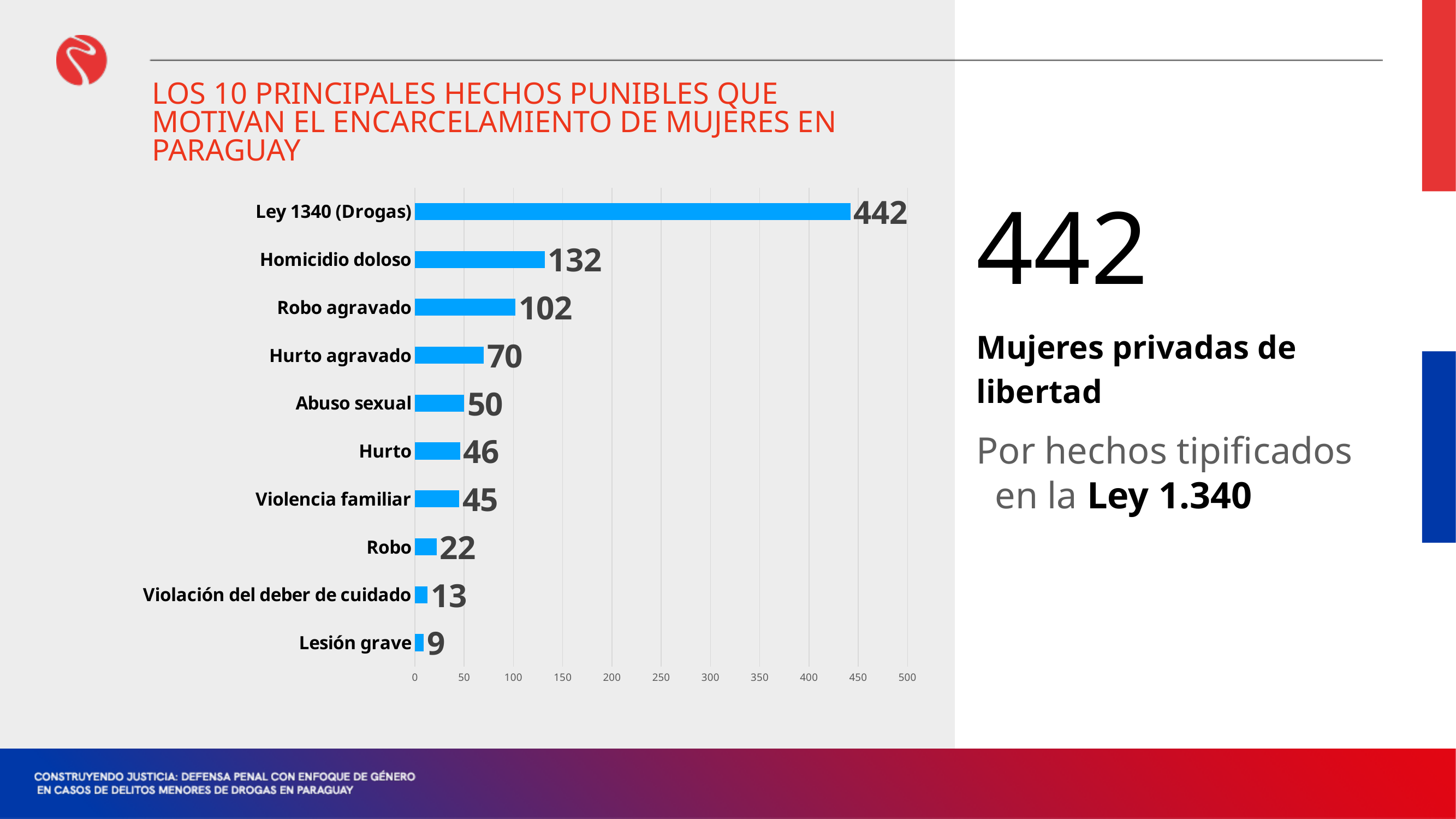
What is the difference between the values for Homicidio doloso and Robo agravado? 30 What is the value for Homicidio doloso? 132 What is the maximum value shown on the horizontal axis of the chart? 500 What kind of chart is shown on the slide? Bar chart What is the value for Ley 1340 (Drogas)? 442 What is the value for Violación del deber de cuidado? 13 Which is larger, the value for Hurto agravado or the value for Abuso sexual? Hurto agravado What is the value for Violencia familiar? 45 Which category has the lowest value? Lesión grave What is the difference between the values for Ley 1340 (Drogas) and Homicidio doloso? 310 Which category has the highest value? Ley 1340 (Drogas) How many categories are shown in the chart? 10